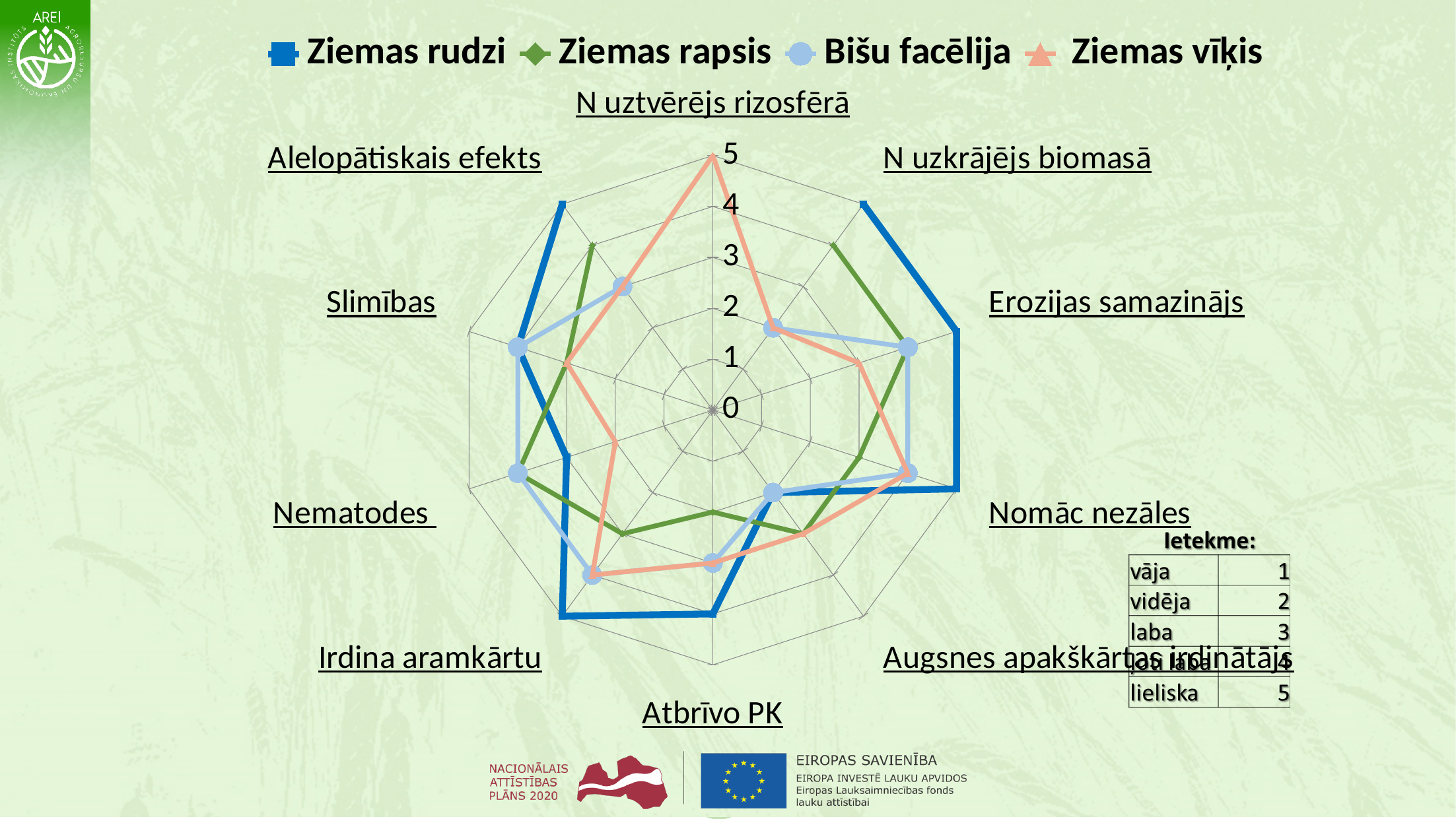
Is the value of Ziemas rudzi for Nomāc nezāles greater or less than 4? greater How many category axes does the radar chart have? 10 What is the value of Ziemas vīķis for N uztvērējs rizosfērā? 5 What kind of chart is shown on the slide? Radar chart How many series does the legend list? 4 Which series has the lowest value for Nematodes? Ziemas vīķis Which series has the highest value for Erozijas samazinājs? Ziemas rudzi Which series has the highest value for N uztvērējs rizosfērā? Ziemas vīķis Which is larger for Atbrīvo PK: Ziemas rudzi or Ziemas rapsis? Ziemas rudzi Which series has the highest value for Alelopātiskais efekts? Ziemas rudzi What is the maximum value shown on the radial axis of the chart? 5 Which series has the lowest value for Atbrīvo PK? Ziemas rapsis